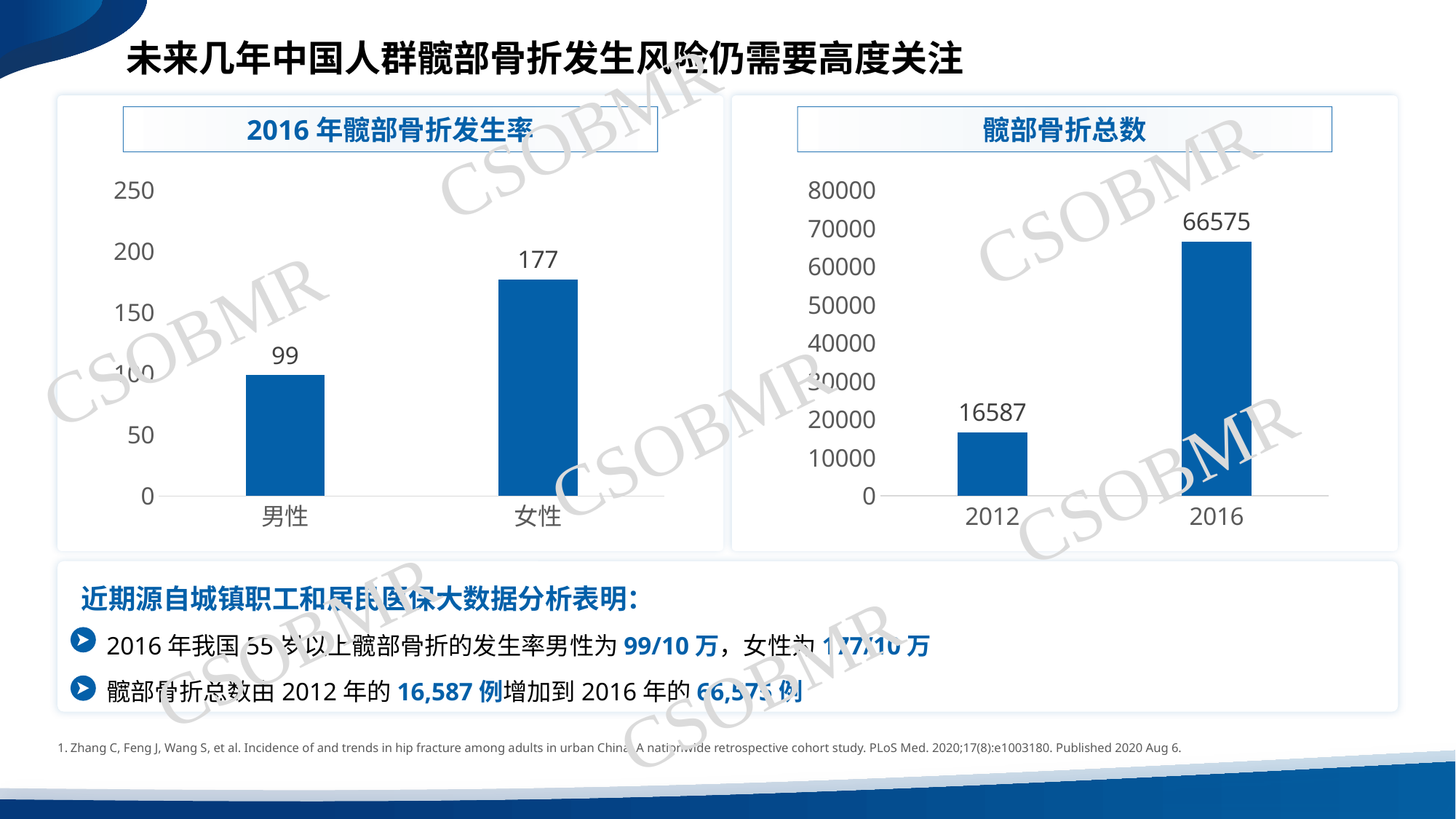
In the left chart titled 2016 年髋部骨折发生率, what is the difference between the values for 女性 and 男性? 78 In the right chart titled 髋部骨折总数, which year has the lower value? 2012 In the right chart titled 髋部骨折总数, do the values rise or fall from 2012 to 2016? rise How many categories are shown in the left chart titled 2016 年髋部骨折发生率? 2 What kind of chart is the right chart titled 髋部骨折总数? bar chart In the left chart titled 2016 年髋部骨折发生率, is the value for 女性 greater or less than 150? greater In the right chart titled 髋部骨折总数, what is the value for 2012? 16587 In the left chart titled 2016 年髋部骨折发生率, what is the value for 女性? 177 In the left chart titled 2016 年髋部骨折发生率, what is the value for 男性? 99 In the right chart titled 髋部骨折总数, what is the value for 2016? 66575 In the left chart titled 2016 年髋部骨折发生率, which category has the higher value? 女性 In the right chart titled 髋部骨折总数, what is the difference between the 2016 and 2012 values? 49988